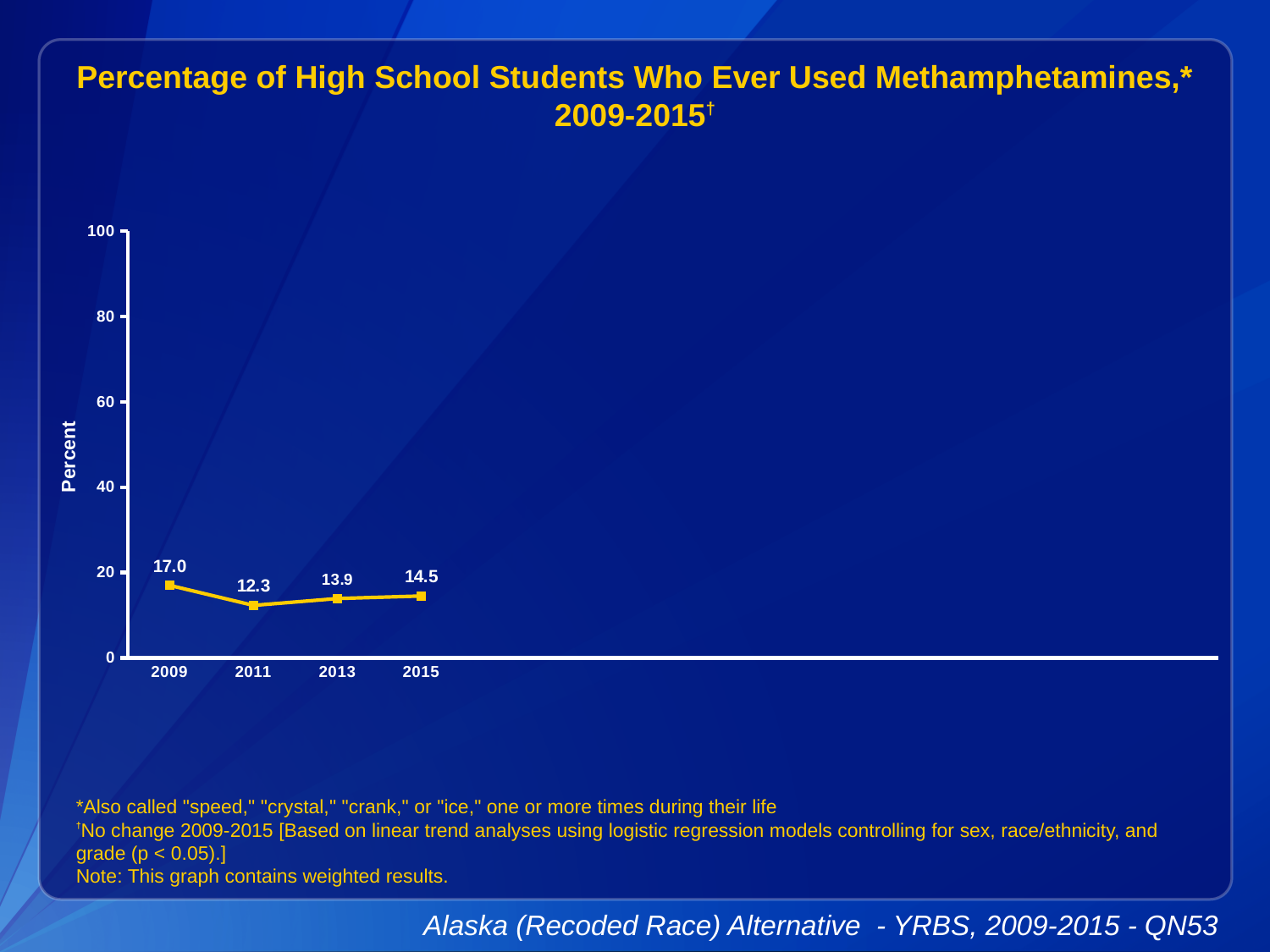
What is the value plotted for 2011? 12.3 What percentage of high school students had ever used methamphetamines in 2009? 17.0 What is the value plotted for 2015? 14.5 Did the percentage rise or fall from 2011 to 2015? rise What kind of chart is shown on the slide? line chart What is the label on the y axis? Percent How many years are plotted on the chart? 4 Which is larger, the value for 2013 or the value for 2015? 2015 Is the value for 2009 greater or less than 20? less Which year has the highest percentage? 2009 Which year has the lowest percentage? 2011 What is the difference between the 2009 value and the 2011 value? 4.7